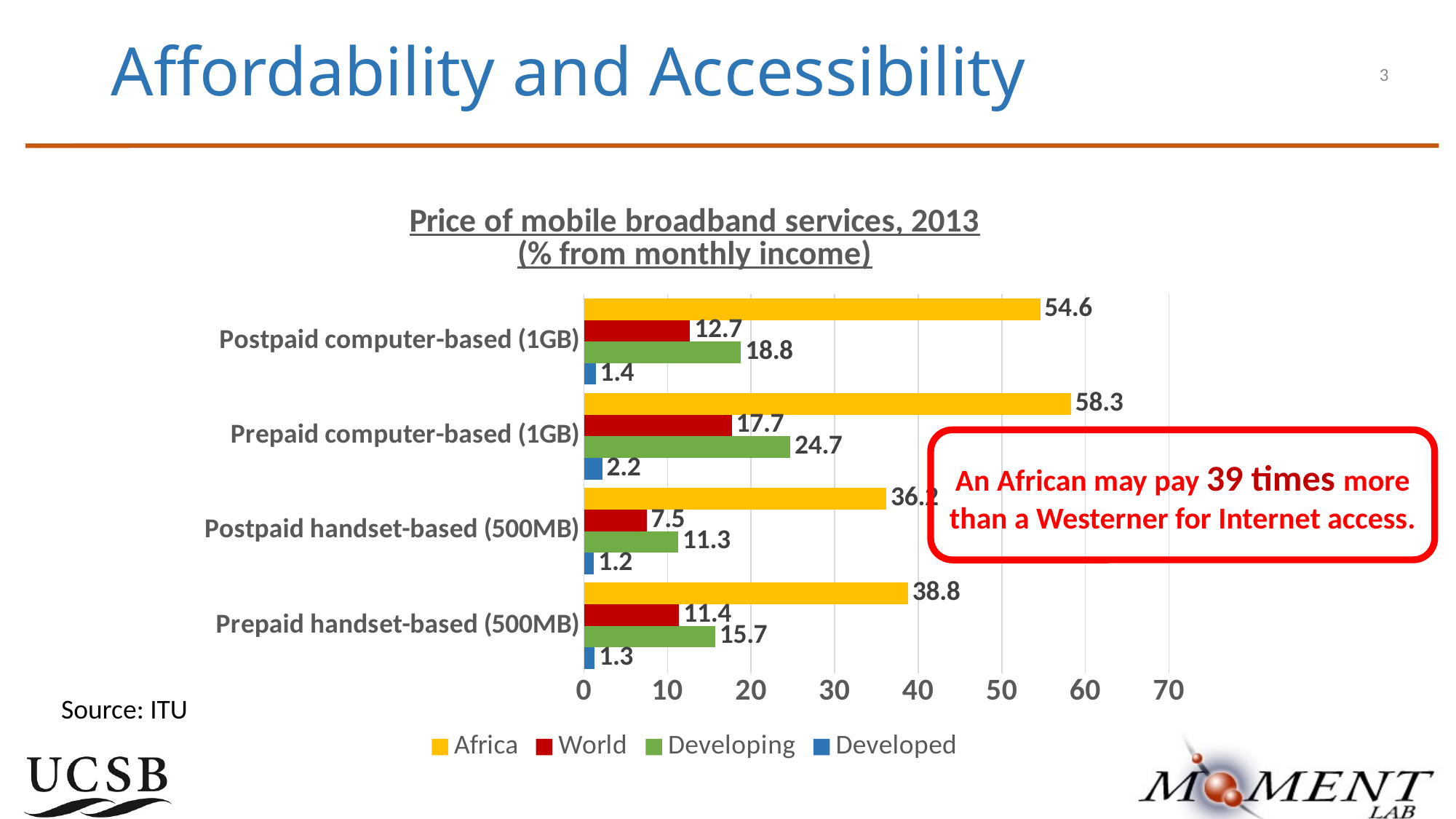
Which is larger for Prepaid computer-based (1GB): the World value or the Developing value? Developing Is the Africa value for Prepaid handset-based (500MB) greater or less than 30? greater What is the Africa value for Prepaid computer-based (1GB)? 58.3 Which category has the highest Africa value? Prepaid computer-based (1GB) What is the Developed value for Postpaid handset-based (500MB)? 1.2 What is the Developing value for Postpaid computer-based (1GB)? 18.8 What is the World value for Prepaid handset-based (500MB)? 11.4 Which category has the lowest World value? Postpaid handset-based (500MB) What type of chart is shown on the slide? Bar chart How many categories are shown on the chart? 4 How many series does the legend list? 4 What is the difference between the Africa and Developed values for Postpaid computer-based (1GB)? 53.2